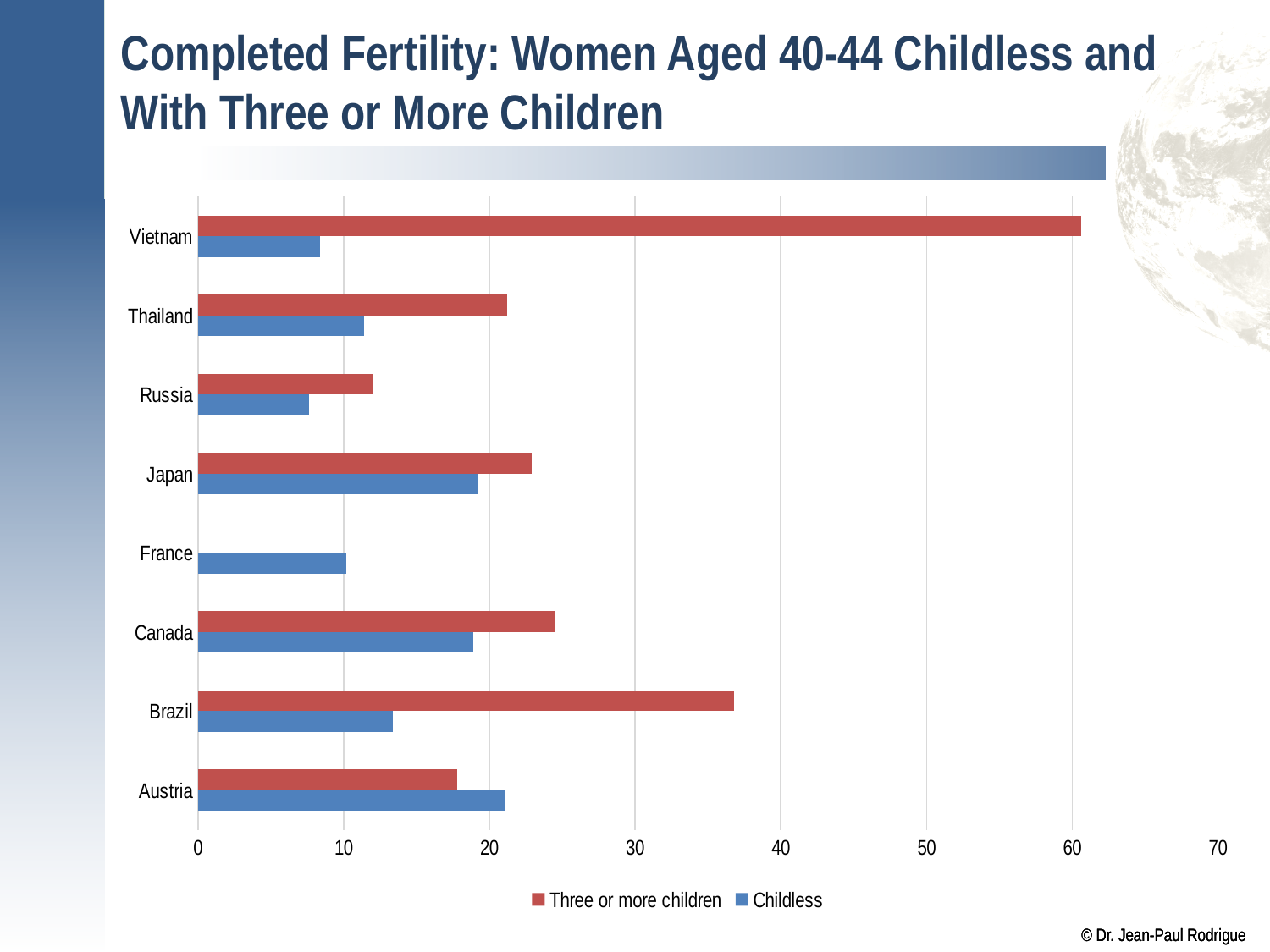
Is the 'Three or more children' value for Vietnam greater or less than 50? greater Which colour represents the 'Childless' series in the chart? blue How many series does the legend list? 2 Which country has the highest value for 'Childless'? Austria What kind of chart is shown on the slide? bar chart Which country has the highest value for 'Three or more children'? Vietnam Which has the larger 'Three or more children' value, Brazil or Canada? Brazil Is the 'Three or more children' value for Brazil greater or less than 30? greater Is the 'Childless' value for Russia greater or less than 10? less How many countries are shown on the chart? 8 For Austria, which is larger: the 'Childless' value or the 'Three or more children' value? Childless